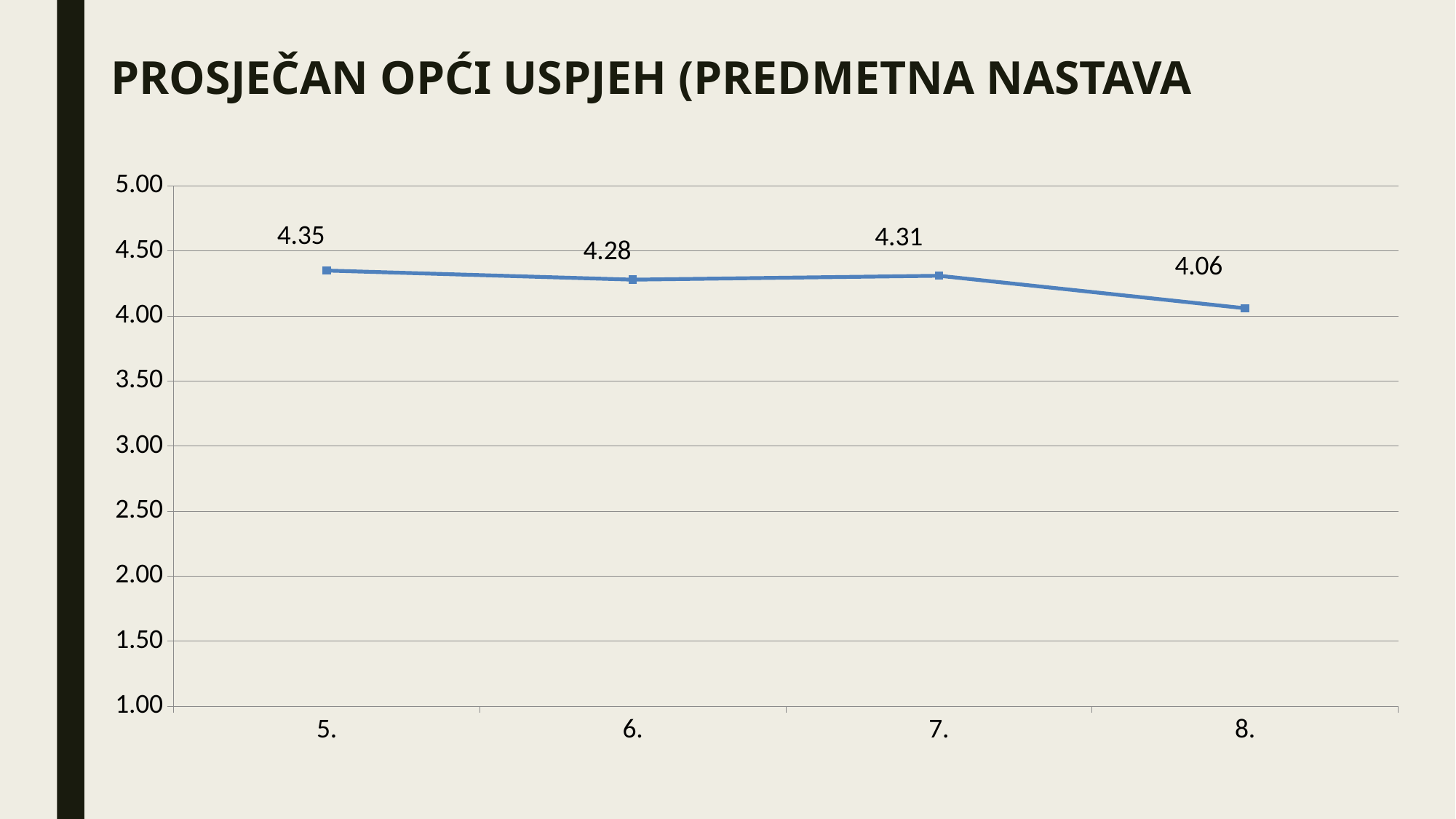
What kind of chart is shown on the slide? line chart Which grade has the highest value? 5. Which grade has the lowest value? 8. What is the value for grade 7.? 4.31 Which is larger, the value for grade 6. or grade 7.? 7. What is the difference between the values for grade 5. and grade 8.? 0.29 What is the value for grade 5.? 4.35 What is the title of the slide? PROSJEČAN OPĆI USPJEH (PREDMETNA NASTAVA Is the value for grade 8. greater or less than 4.50? less How many data points are plotted on the chart? 4 What is the value for grade 8.? 4.06 What is the value for grade 6.? 4.28